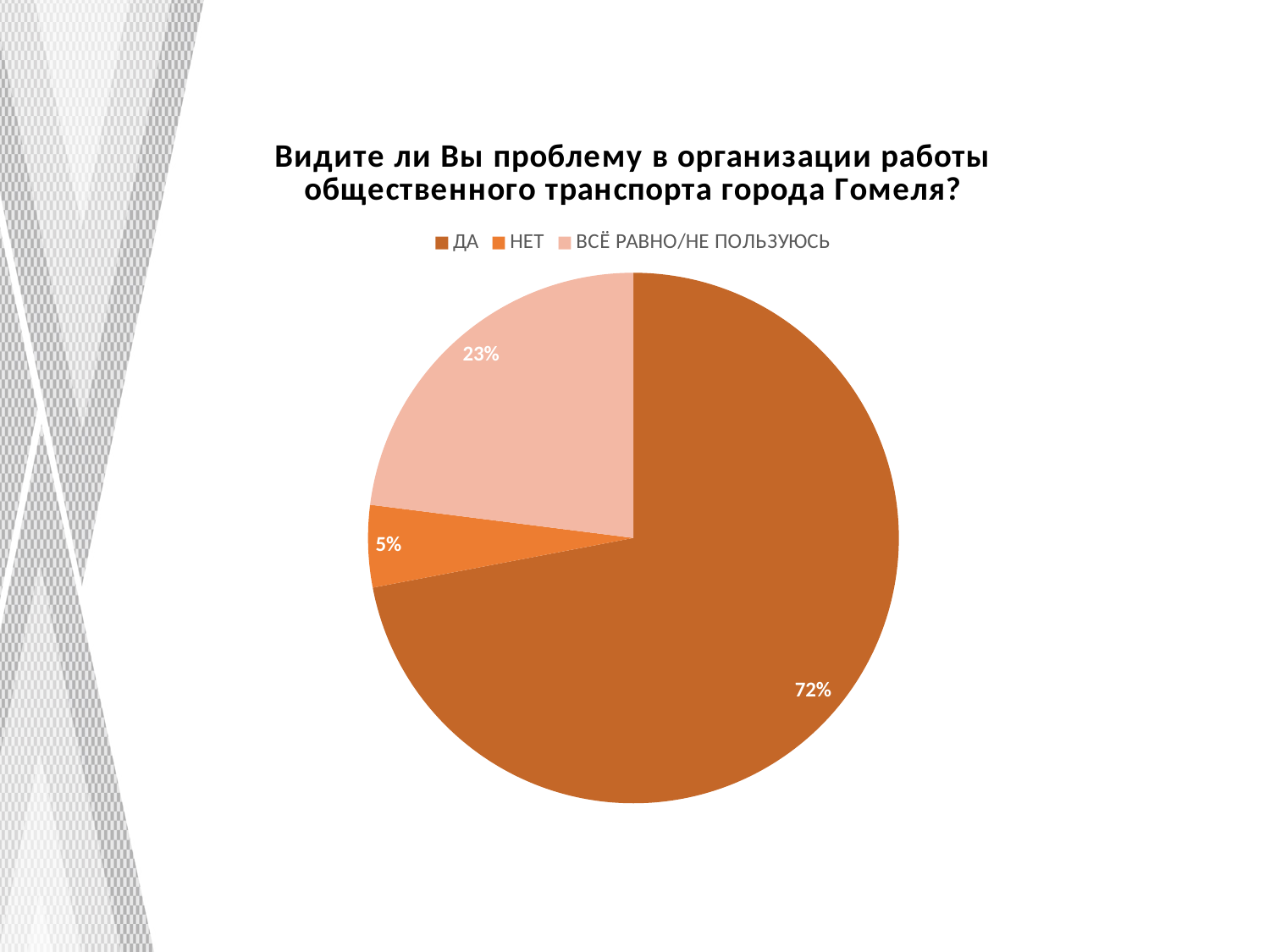
How many slices does the pie chart have? 3 What share of respondents answered НЕТ? 5% What is the title of the chart? Видите ли Вы проблему в организации работы общественного транспорта города Гомеля? Which is larger, the share for НЕТ or the share for ВСЁ РАВНО/НЕ ПОЛЬЗУЮСЬ? ВСЁ РАВНО/НЕ ПОЛЬЗУЮСЬ What is the difference in percentage points between the ДА and ВСЁ РАВНО/НЕ ПОЛЬЗУЮСЬ slices? 49 What kind of chart is shown on the slide? pie chart What share of respondents answered ВСЁ РАВНО/НЕ ПОЛЬЗУЮСЬ? 23% What is the difference in percentage points between the ВСЁ РАВНО/НЕ ПОЛЬЗУЮСЬ and НЕТ slices? 18 Which answer has the smallest share of the pie? НЕТ What share of respondents answered ДА? 72% How many entries does the legend list? 3 Which answer has the largest share of the pie? ДА